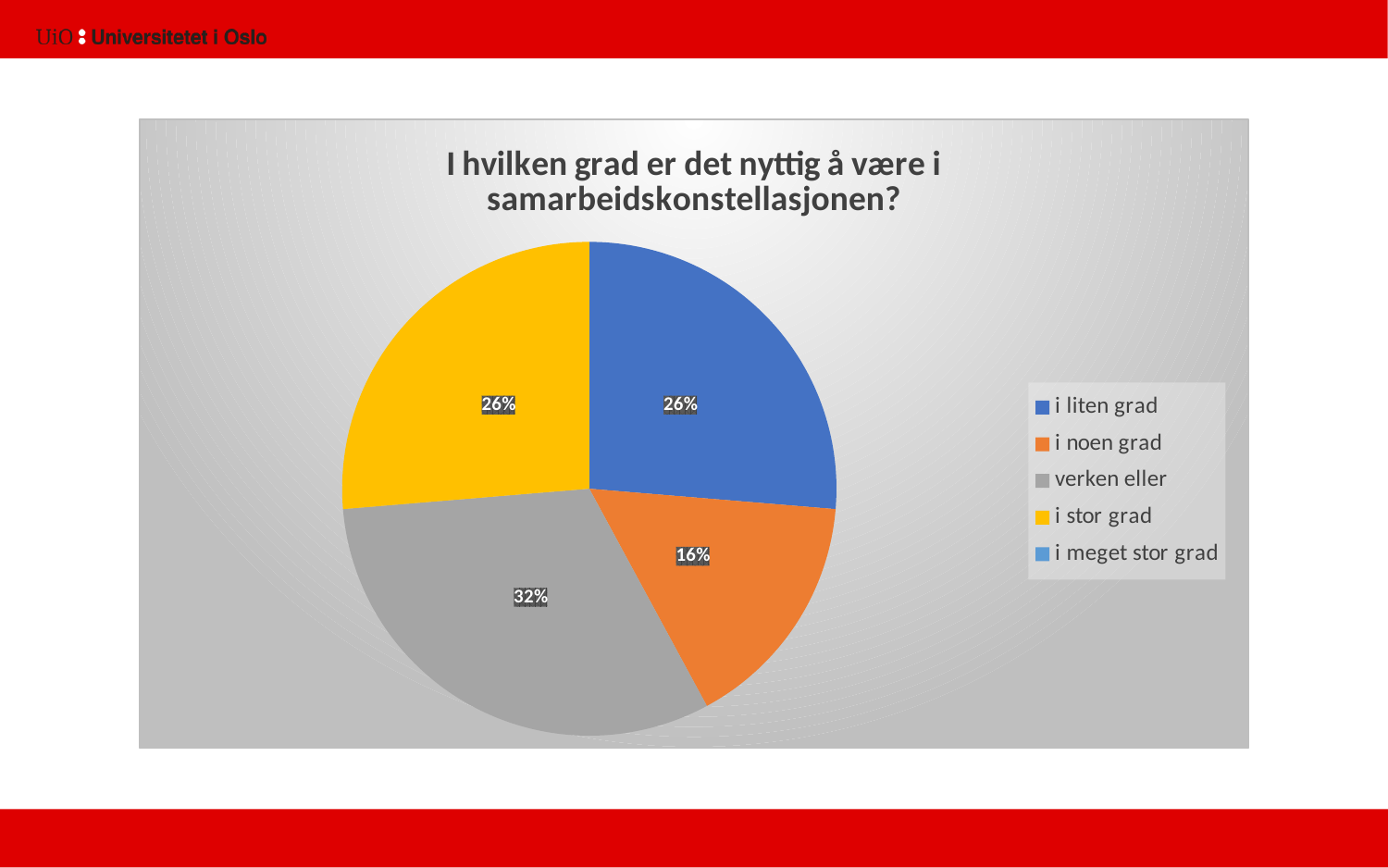
What percentage of the pie is labelled for 'i noen grad'? 16% What is the difference in percentage points between the 'verken eller' slice and the 'i noen grad' slice? 16 Among the slices with a printed label, which category has the smallest share? i noen grad What kind of chart is shown on the slide? pie chart What colour is the slice for 'i stor grad'? yellow What is the title of the chart? I hvilken grad er det nyttig å være i samarbeidskonstellasjonen? Which category has the largest slice of the pie? verken eller What percentage of the pie is labelled for 'verken eller'? 32% What percentage of the pie is labelled for 'i liten grad'? 26% What percentage of the pie is labelled for 'i stor grad'? 26% How many categories does the legend list? 5 Which slice is larger, 'verken eller' or 'i liten grad'? verken eller